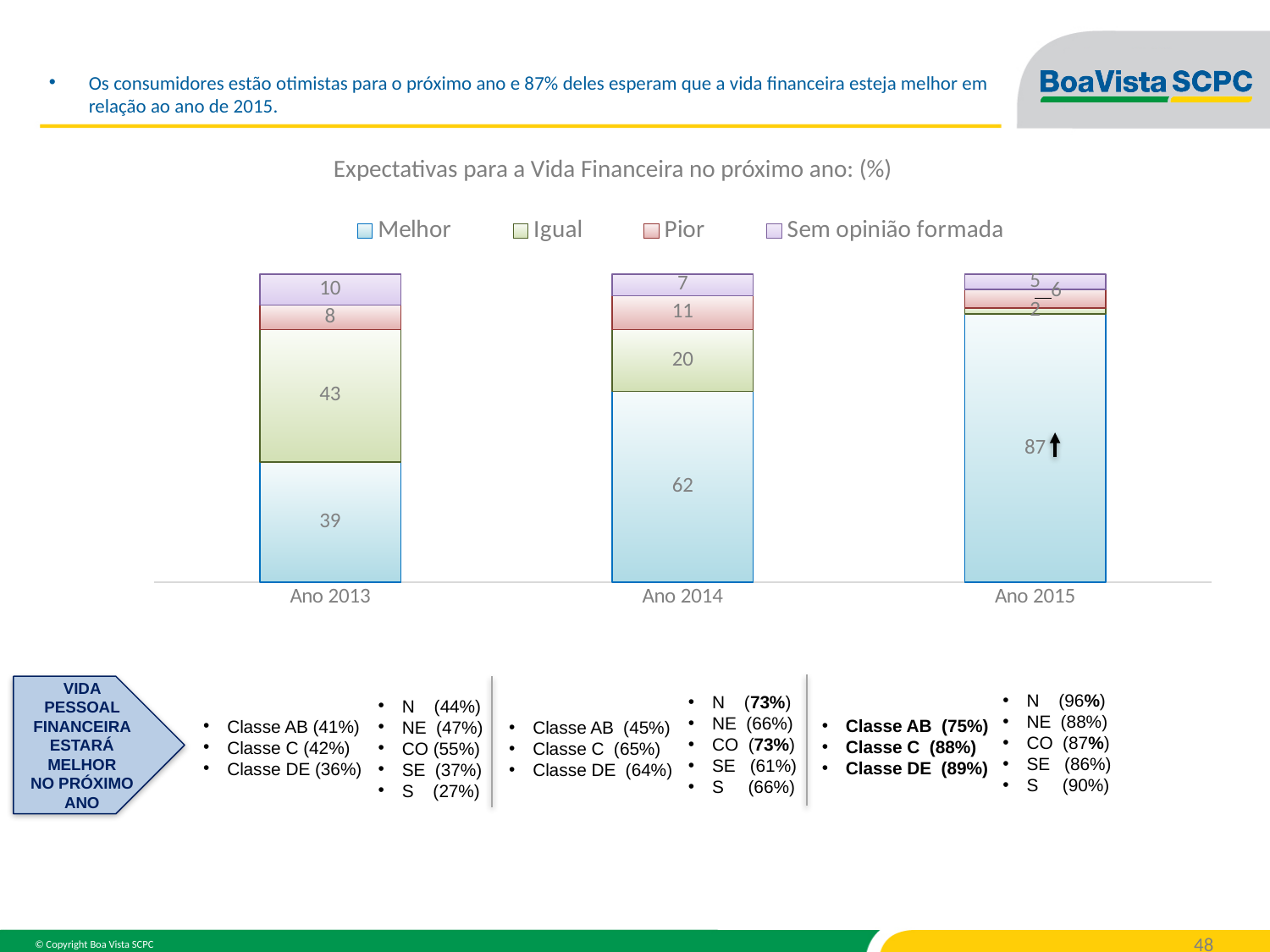
In which year is the Melhor segment the largest? Ano 2015 Does the Melhor value rise or fall from Ano 2013 to Ano 2015? Rises What type of chart is shown on the slide? Stacked bar chart What is the value of the Melhor segment for Ano 2015? 87 What is the value of the Sem opinião formada segment for Ano 2013? 10 How many years are shown on the x axis of the chart? 3 In which year is the Igual segment the smallest? Ano 2015 How many series does the chart legend list? 4 What is the value of the Igual segment for Ano 2014? 20 By how much did the Melhor value increase from Ano 2013 to Ano 2014? 23 Which year has the larger Pior value, Ano 2013 or Ano 2014? Ano 2014 What is the value of the Melhor segment for Ano 2013? 39